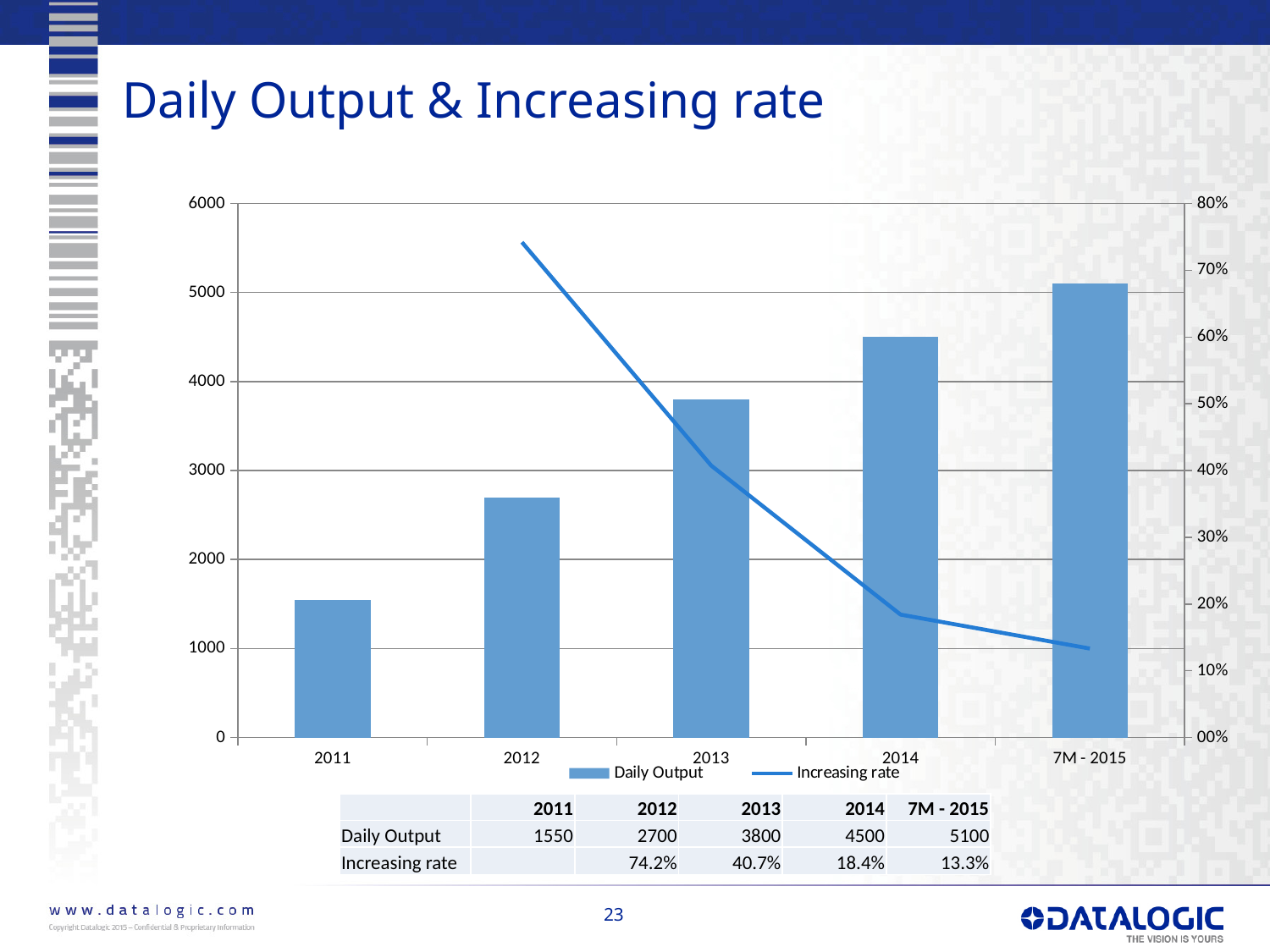
Is the Daily Output for 2012 greater or less than 3000? less What is the Increasing rate for 2012? 74.2% Which is larger, the Increasing rate for 2013 or for 2014? 2013 What is the difference in Daily Output between 2014 and 2011? 2950 What is the Daily Output for 7M - 2015? 5100 How many series does the legend list? 2 Does the Increasing rate rise or fall from 2012 to 7M - 2015? fall What is the title of the slide? Daily Output & Increasing rate Which category has the lowest Increasing rate? 7M - 2015 What is the Daily Output for 2013? 3800 How many categories are shown on the x axis? 5 Which category has the highest Daily Output? 7M - 2015